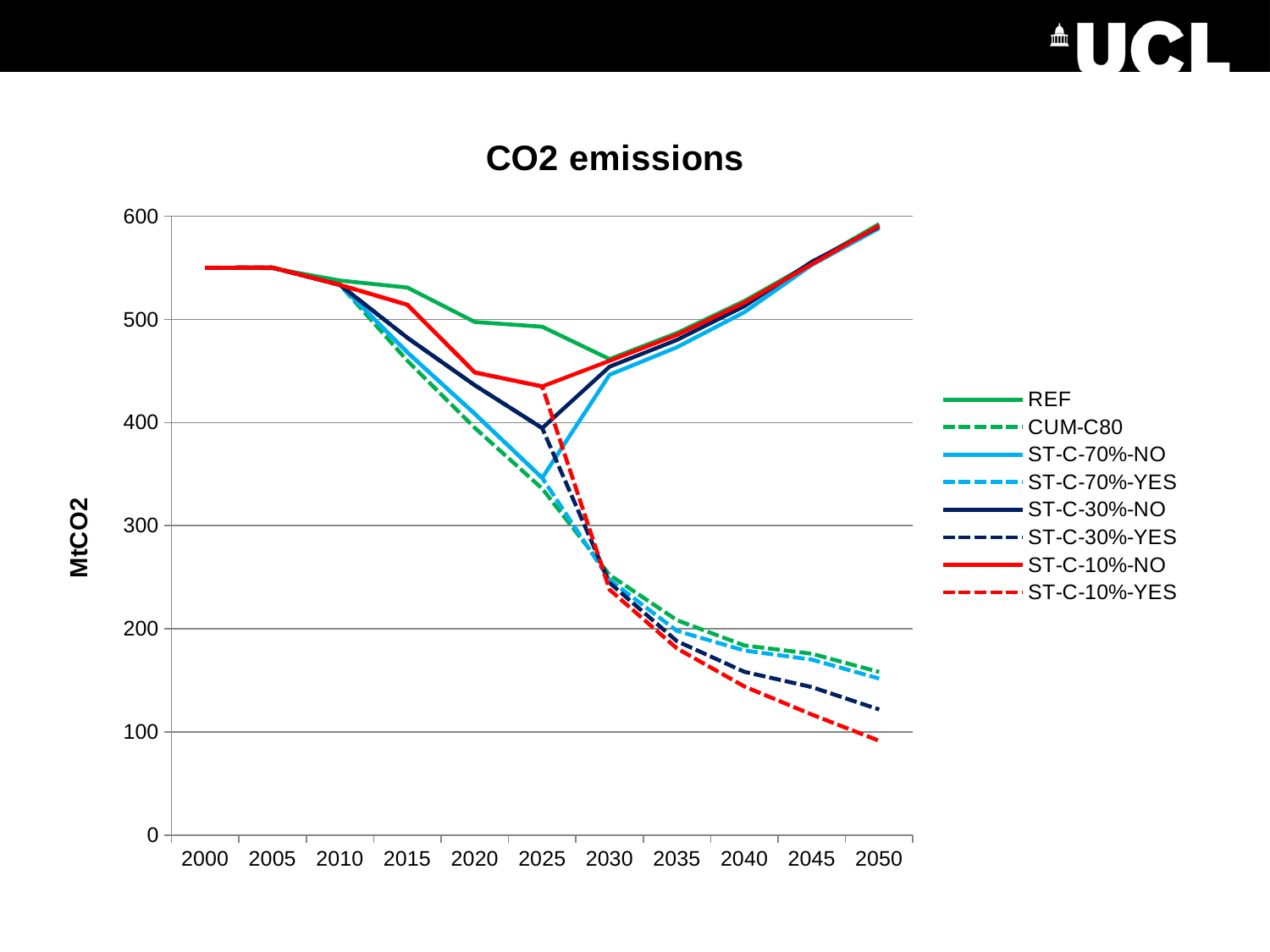
Which series has the lowest value in 2050? ST-C-10%-YES Is the value for ST-C-70%-NO in 2025 greater or less than 400? less How many series does the legend list? 8 What is the title of the chart? CO2 emissions Is the value for ST-C-30%-YES in 2050 greater or less than 100? greater What kind of chart is shown on the slide? line chart How many years are marked along the x axis? 11 Is the value for CUM-C80 in 2040 greater or less than 200? less What is the label on the y axis? MtCO2 In 2050, which is larger: ST-C-30%-YES or ST-C-10%-YES? ST-C-30%-YES